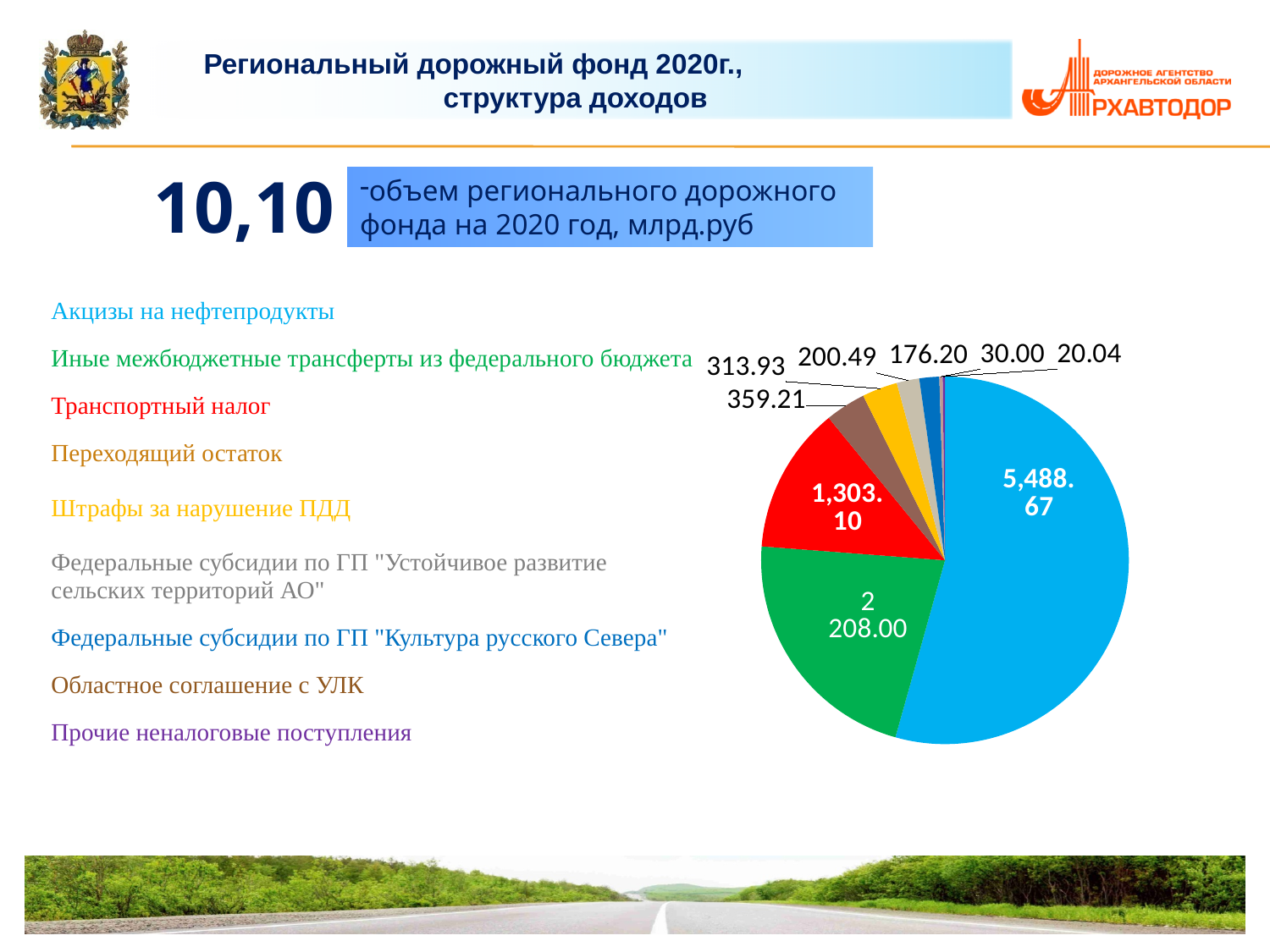
What is the difference between the values for Акцизы на нефтепродукты and Иные межбюджетные трансферты из федерального бюджета? 3,280.67 Which category has the largest slice in the pie chart? Акцизы на нефтепродукты What is the value of the slice for Транспортный налог? 1,303.10 How many slices does the pie chart have? 9 What colour is the largest slice of the pie chart? blue What is the value of the slice for Штрафы за нарушение ПДД? 313.93 What is the value of the slice for Иные межбюджетные трансферты из федерального бюджета? 2,208.00 What kind of chart is shown on the slide? pie chart Which is larger: the slice for Транспортный налог or the slice for Переходящий остаток? Транспортный налог Which category has the smallest slice in the pie chart? Прочие неналоговые поступления What is the value of the slice for Акцизы на нефтепродукты? 5,488.67 What is the value of the slice for Переходящий остаток? 359.21